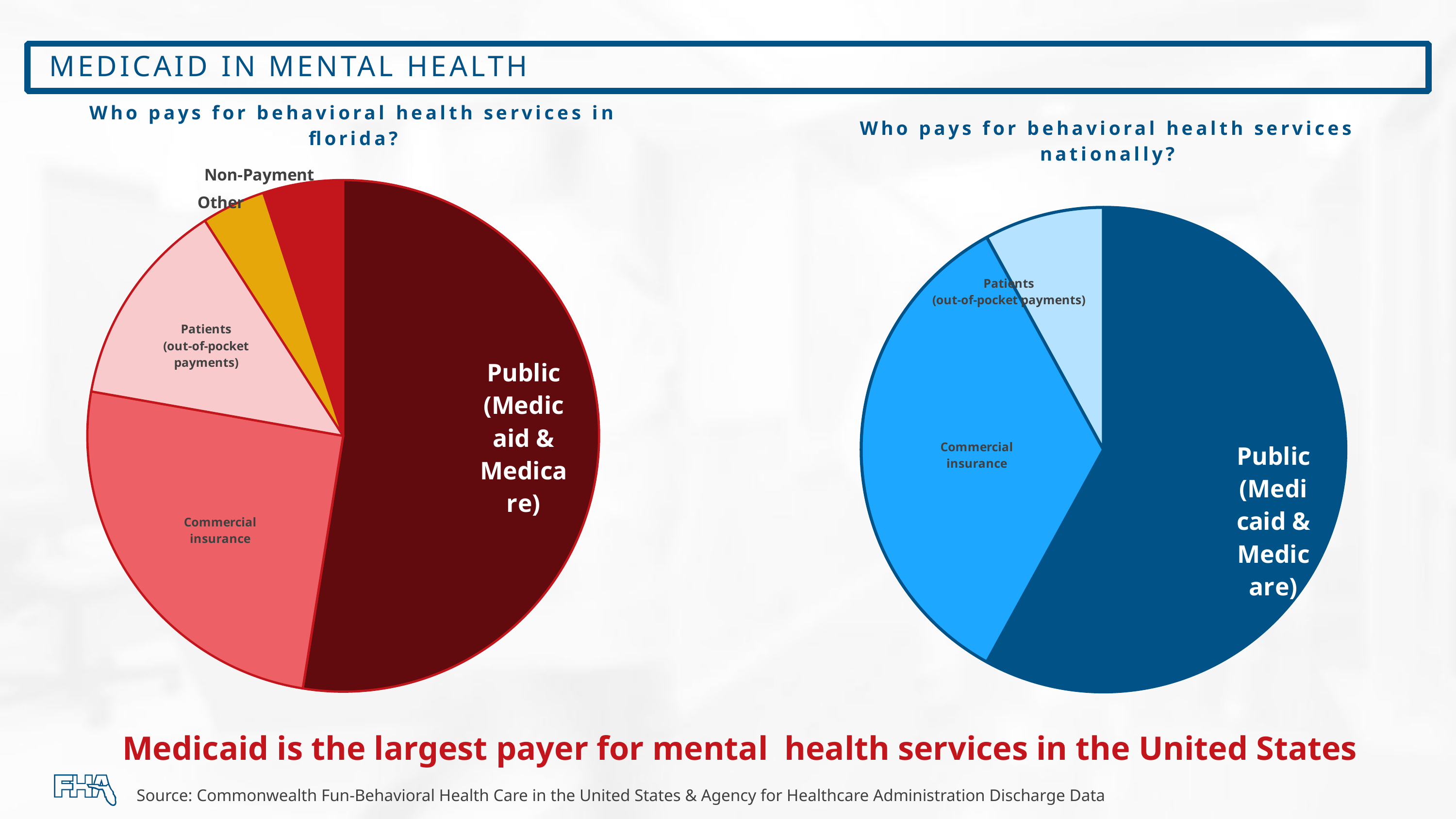
What kind of chart is the "Who pays for behavioral health services nationally?" chart? pie chart In the "Who pays for behavioral health services nationally?" chart, which slice is larger: Commercial insurance or Patients (out-of-pocket payments)? Commercial insurance In the "Who pays for behavioral health services in florida?" chart, which slice is larger: Public (Medicaid & Medicare) or Commercial insurance? Public (Medicaid & Medicare) How many pie charts are shown on the slide? 2 In the "Who pays for behavioral health services nationally?" chart, which payer has the largest slice? Public (Medicaid & Medicare) What is the title of the pie chart on the right side of the slide? Who pays for behavioral health services nationally? What kind of chart is the "Who pays for behavioral health services in florida?" chart? pie chart How many slices does the "Who pays for behavioral health services nationally?" pie chart have? 3 In the "Who pays for behavioral health services nationally?" chart, which payer has the smallest slice? Patients (out-of-pocket payments) How many slices does the "Who pays for behavioral health services in florida?" pie chart have? 5 In the "Who pays for behavioral health services in florida?" chart, which payer has the largest slice? Public (Medicaid & Medicare) In the "Who pays for behavioral health services in florida?" chart, which slice is larger: Commercial insurance or Patients (out-of-pocket payments)? Commercial insurance